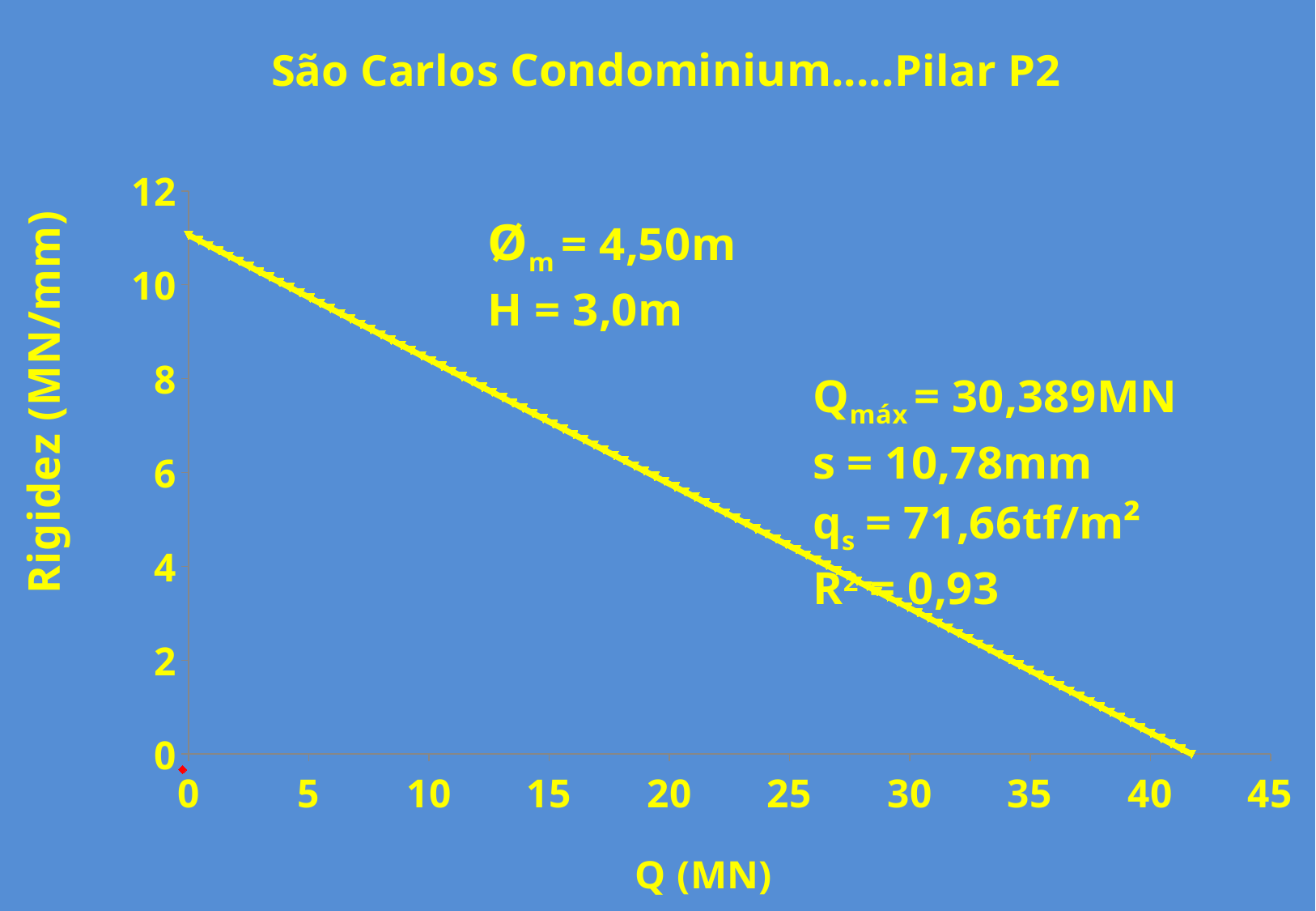
What R² value is printed on the chart? 0,93 Is the Rigidez value at Q = 30 MN greater or less than 2 MN/mm? greater What is the label of the y axis? Rigidez (MN/mm) Is the Rigidez value at Q = 40 MN greater or less than 2 MN/mm? less What is the value of Qmáx printed on the chart? 30,389MN Does the Rigidez value rise or fall as Q increases along the x axis? fall Is the Rigidez value at Q = 10 MN greater or less than 6 MN/mm? greater What kind of chart is shown on the slide? line chart What is the title of the chart? São Carlos Condominium.....Pilar P2